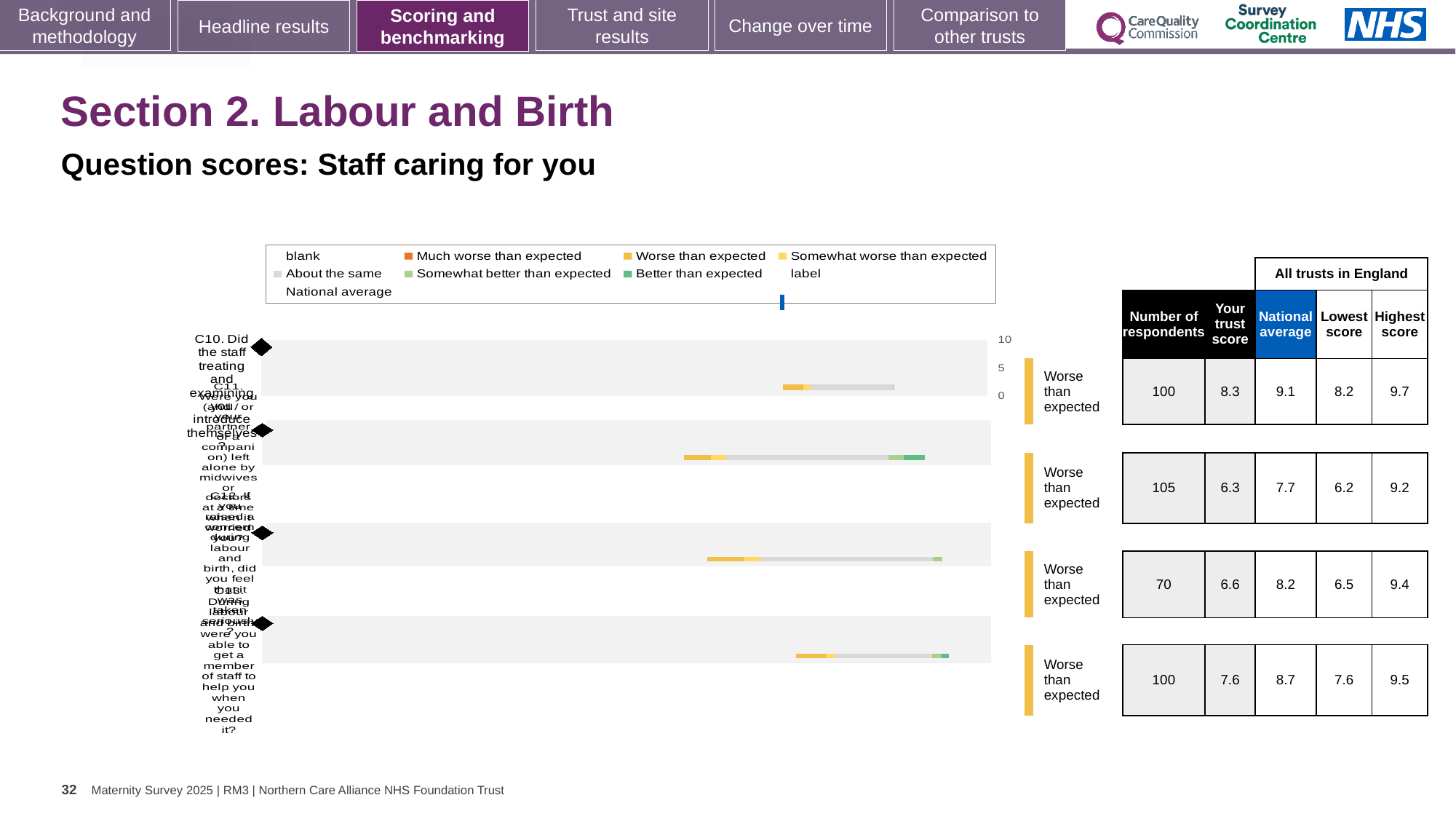
Which row has the highest 'Your trust score' in the table? the first row (8.3) In the fourth row, is 'Your trust score' higher or lower than the 'National average'? lower In the table, what is the 'National average' for the second row? 7.7 How many question rows are plotted in the chart? 4 What kind of chart is shown on the slide? bar chart In the table, what is the 'Number of respondents' for the third row? 70 In the table, what is the 'Highest score' for the fourth row? 9.5 In the first row, what is the difference between the 'National average' and 'Your trust score'? 0.8 In the chart legend, what colour represents 'Much worse than expected'? orange Which row has the lowest 'Your trust score' in the table? the second row (6.3) In the table, what is 'Your trust score' for the first row? 8.3 What benchmark label is shown next to each of the four rows in the chart? Worse than expected